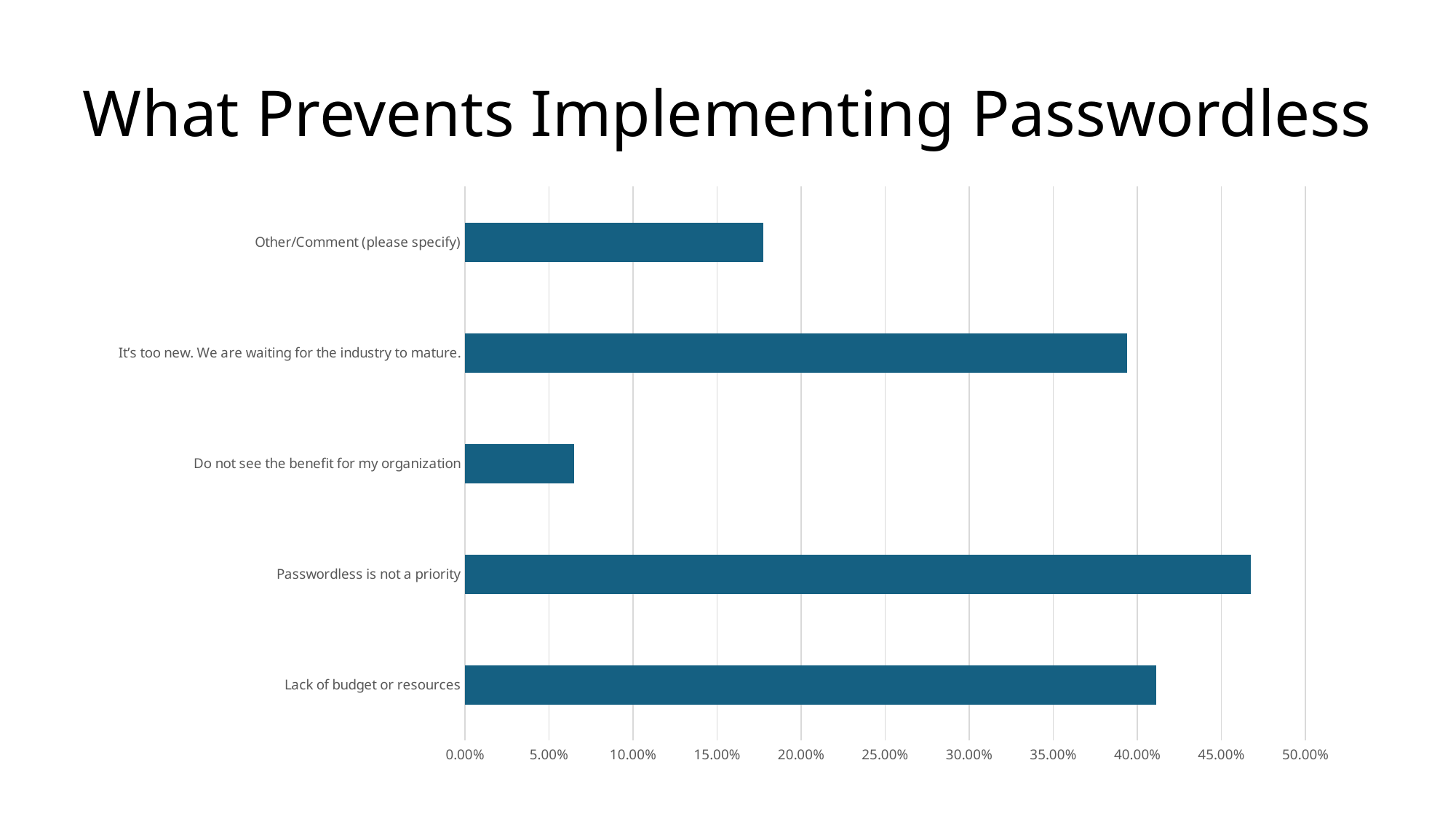
Is the value for "Other/Comment (please specify)" greater or less than 15.00%? greater Which is larger: the value for "Other/Comment (please specify)" or the value for "Do not see the benefit for my organization"? Other/Comment (please specify) How many categories are plotted in the chart? 5 Which category has the lowest value? Do not see the benefit for my organization What kind of chart is shown on the slide? bar chart Is the value for "Passwordless is not a priority" greater or less than 45.00%? greater Is the value for "Lack of budget or resources" greater or less than 45.00%? less Which is larger: the value for "Passwordless is not a priority" or the value for "It's too new. We are waiting for the industry to mature."? Passwordless is not a priority What is the title of the slide? What Prevents Implementing Passwordless Which category has the highest value? Passwordless is not a priority